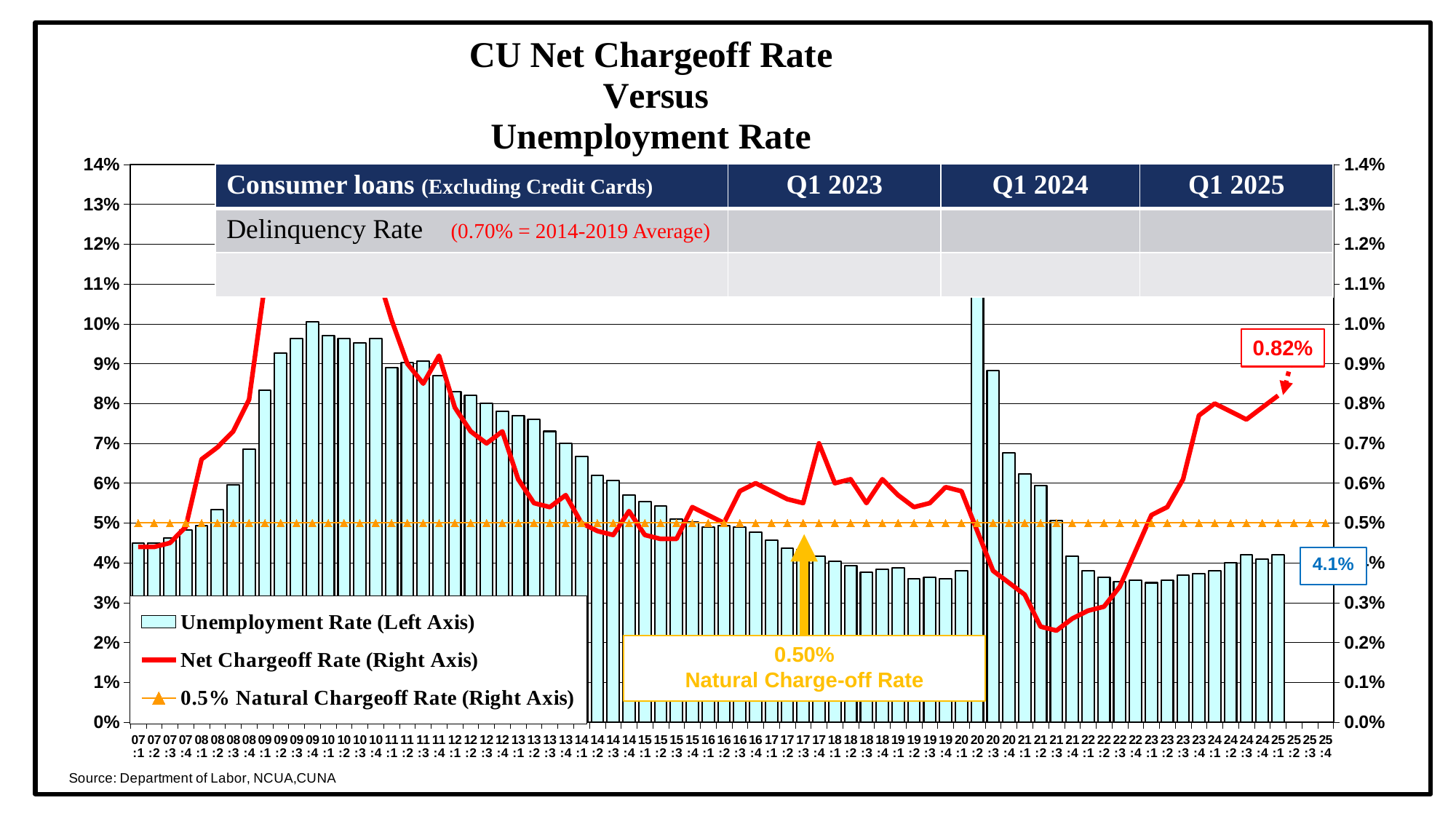
What is the difference between the labeled Net Chargeoff Rate of 0.82% and the 0.50% Natural Charge-off Rate? 0.32% Is the Net Chargeoff Rate for 21:3 greater or less than 0.3%? less Does the Net Chargeoff Rate rise or fall from 22:1 to 25:1? rise What kind of chart is shown on the slide? A combination bar and line chart What is the labeled Net Chargeoff Rate at the end of the series (25:1)? 0.82% What is the labeled Unemployment Rate at the end of the series (25:1)? 4.1% Is the Unemployment Rate bar for 20:2 greater or less than 10%? greater How many series does the legend list? 3 What value is given for the Natural Charge-off Rate? 0.50% Which legend entry is shown with orange triangle markers? 0.5% Natural Chargeoff Rate (Right Axis) Which is larger, the Unemployment Rate in 09:4 or in 19:4? 09:4 Is the Unemployment Rate bar for 09:4 greater or less than 9%? greater